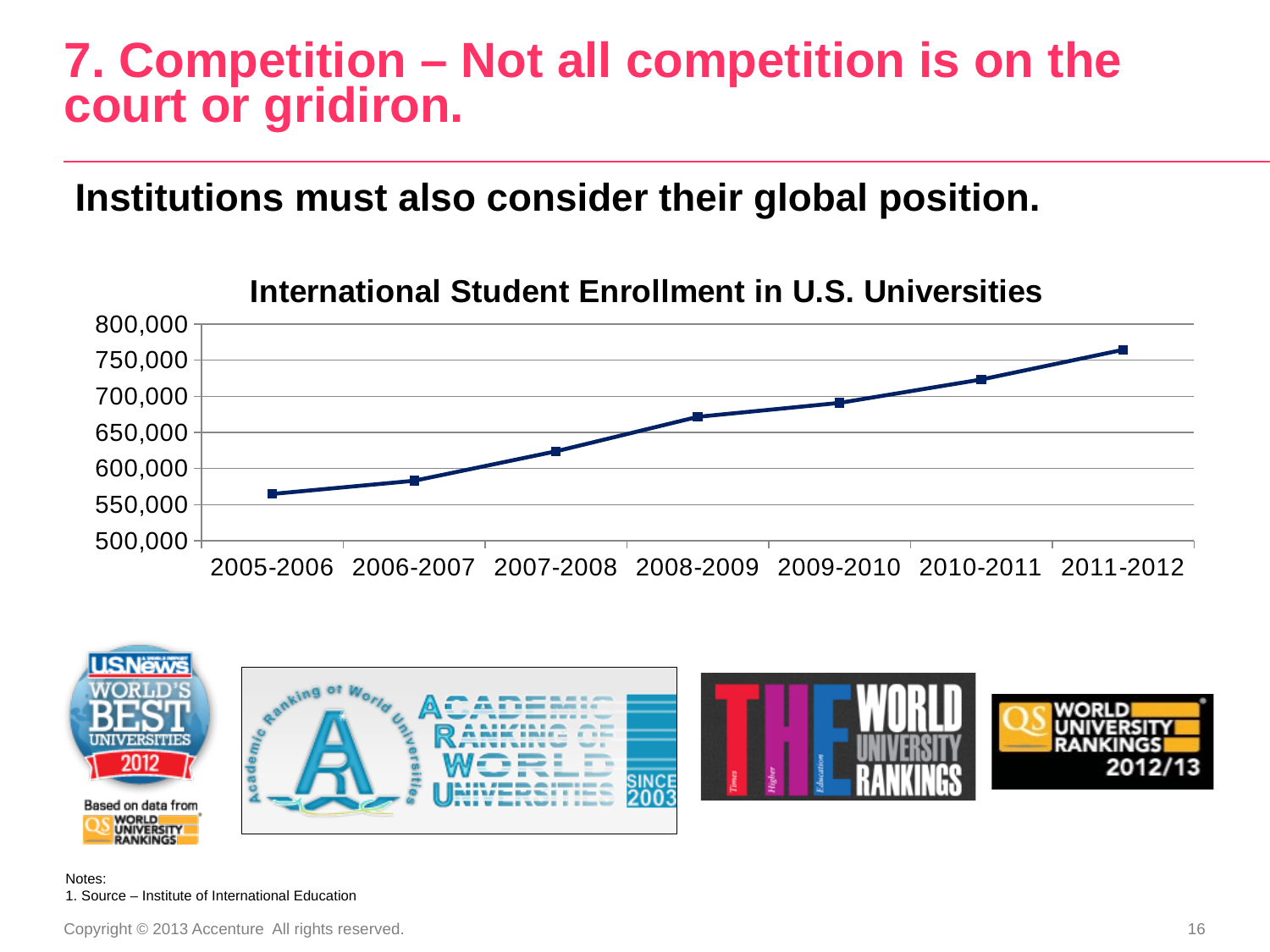
Do the enrollment values rise or fall from 2005-2006 to 2011-2012? Rise Which academic year has the lowest international student enrollment? 2005-2006 How many academic years are plotted on the x axis of the chart? 7 Is the value for 2010-2011 greater or less than 750,000? less What is the title of the chart? International Student Enrollment in U.S. Universities Is the value for 2005-2006 greater or less than 600,000? less Which is larger, the enrollment for 2009-2010 or for 2006-2007? 2009-2010 Is the value for 2007-2008 greater or less than 600,000? greater What type of chart is shown on the slide? Line chart Which academic year has the highest international student enrollment? 2011-2012